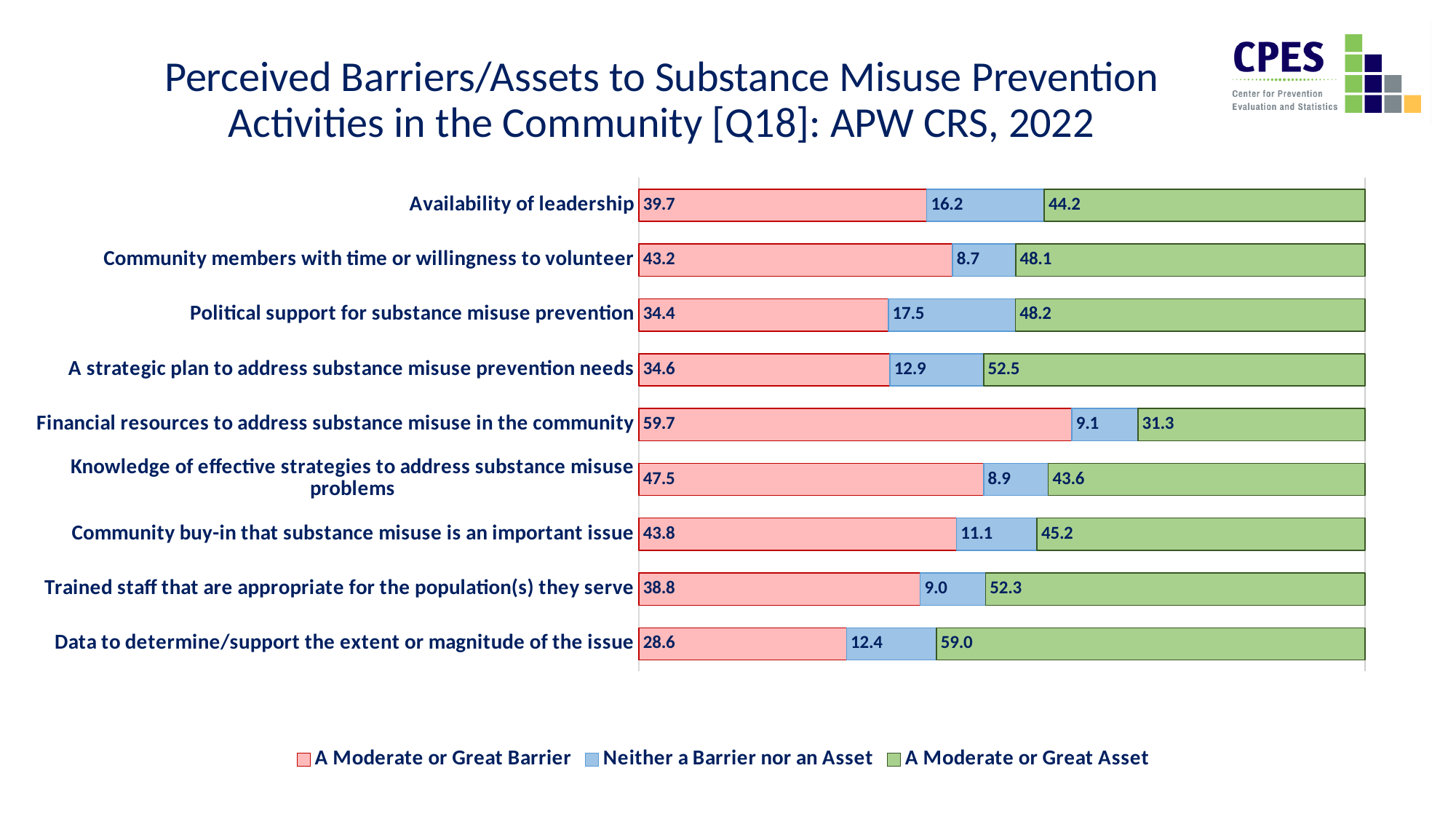
What is the value for 'A Moderate or Great Barrier' for 'Financial resources to address substance misuse in the community'? 59.7 Which category has the lowest value for 'A Moderate or Great Asset'? Financial resources to address substance misuse in the community Which colour represents 'A Moderate or Great Asset' in the chart? Green What type of chart is shown on the slide? Stacked bar chart How many categories (barriers/assets) are plotted on the chart? 9 For 'Financial resources to address substance misuse in the community', what is the difference between the 'A Moderate or Great Barrier' value and the 'A Moderate or Great Asset' value? 28.4 Which category has the highest value for 'A Moderate or Great Barrier'? Financial resources to address substance misuse in the community For 'Knowledge of effective strategies to address substance misuse problems', which is larger: the 'A Moderate or Great Barrier' value or the 'A Moderate or Great Asset' value? A Moderate or Great Barrier How many series does the legend list? 3 What is the value for 'A Moderate or Great Asset' for 'Data to determine/support the extent or magnitude of the issue'? 59.0 Which category has the lowest value for 'A Moderate or Great Barrier'? Data to determine/support the extent or magnitude of the issue What is the value for 'Neither a Barrier nor an Asset' for 'Political support for substance misuse prevention'? 17.5